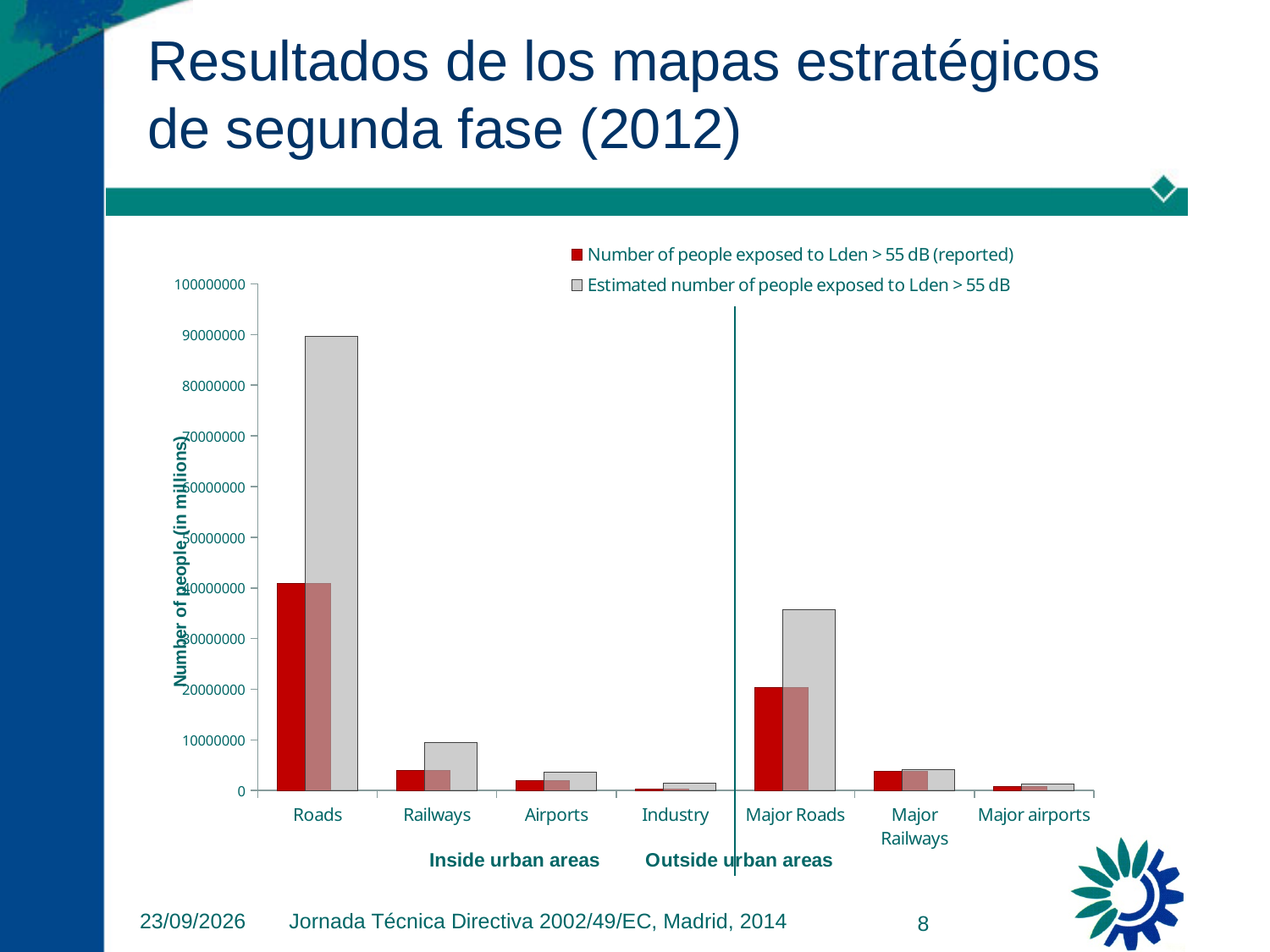
Is the reported number of people exposed for Roads greater or less than 30000000? greater Which category has the highest estimated number of people exposed to Lden > 55 dB? Roads What is the title of the vertical axis of the chart? Number of people (in millions) How many categories are shown along the x axis of the chart? 7 Which has a larger estimated number of people exposed, Railways or Airports? Railways What kind of chart is shown on the slide? bar chart Which category has the highest reported number of people exposed to Lden > 55 dB? Roads How many series does the chart's legend list? 2 Is the estimated number of people exposed for Major Roads greater or less than 30000000? greater Is the estimated number of people exposed for Roads greater or less than 80000000? greater